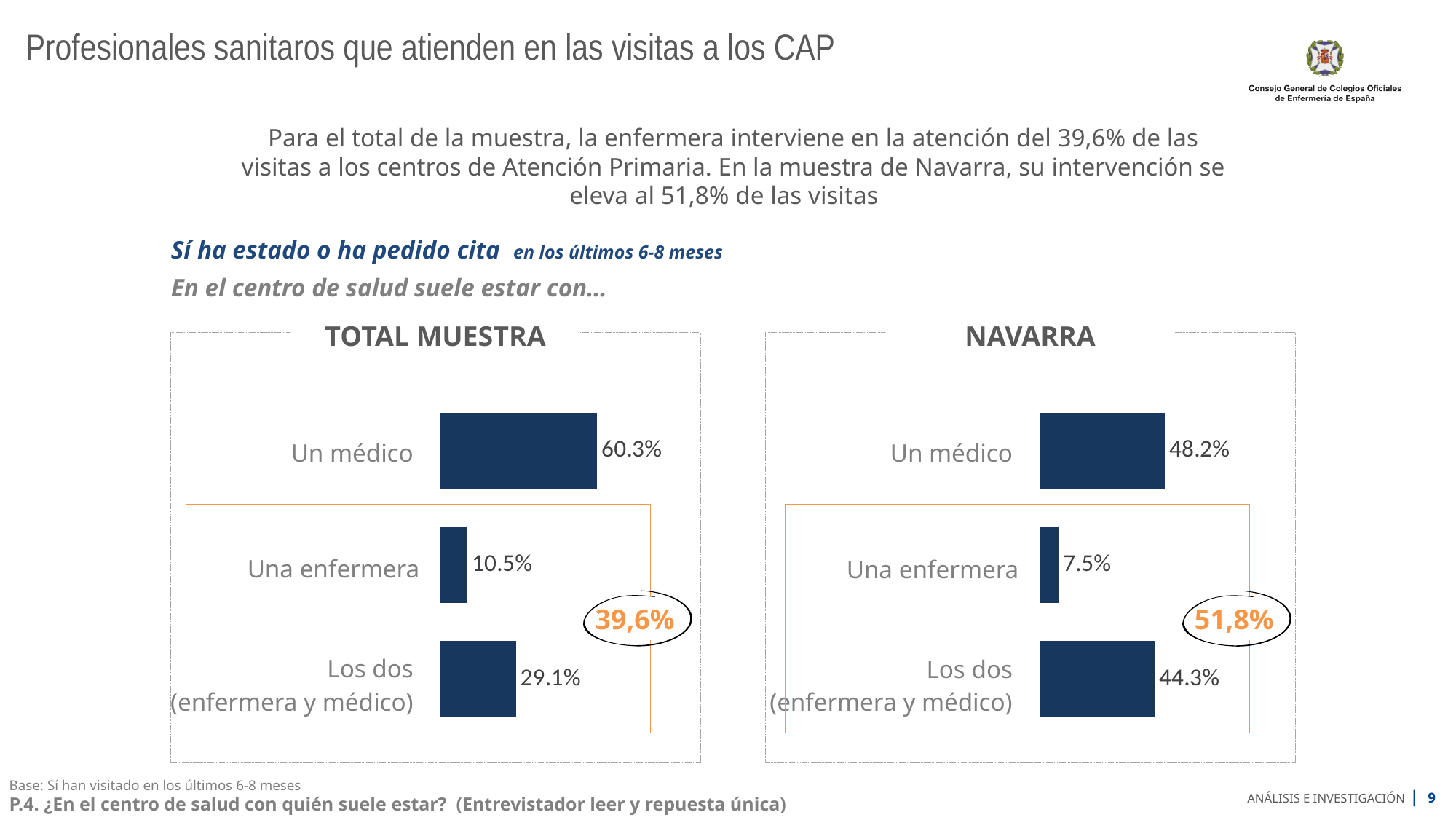
In the NAVARRA chart, what is the value for Una enfermera? 7.5% How many categories does the TOTAL MUESTRA chart show? 3 In the NAVARRA chart, what is the value for Los dos (enfermera y médico)? 44.3% In the TOTAL MUESTRA chart, what is the difference between Un médico and Los dos (enfermera y médico)? 31.2% What percentage is highlighted in the orange circle on the NAVARRA chart? 51,8% In the TOTAL MUESTRA chart, which category has the highest value? Un médico In the NAVARRA chart, which is larger: Un médico or Los dos (enfermera y médico)? Un médico In the NAVARRA chart, what is the difference between Un médico and Los dos (enfermera y médico)? 3.9% What kind of chart is the NAVARRA chart? Bar chart Is the value for Una enfermera larger in the TOTAL MUESTRA chart or the NAVARRA chart? TOTAL MUESTRA In the TOTAL MUESTRA chart, what is the value for Un médico? 60.3% In the NAVARRA chart, which category has the lowest value? Una enfermera